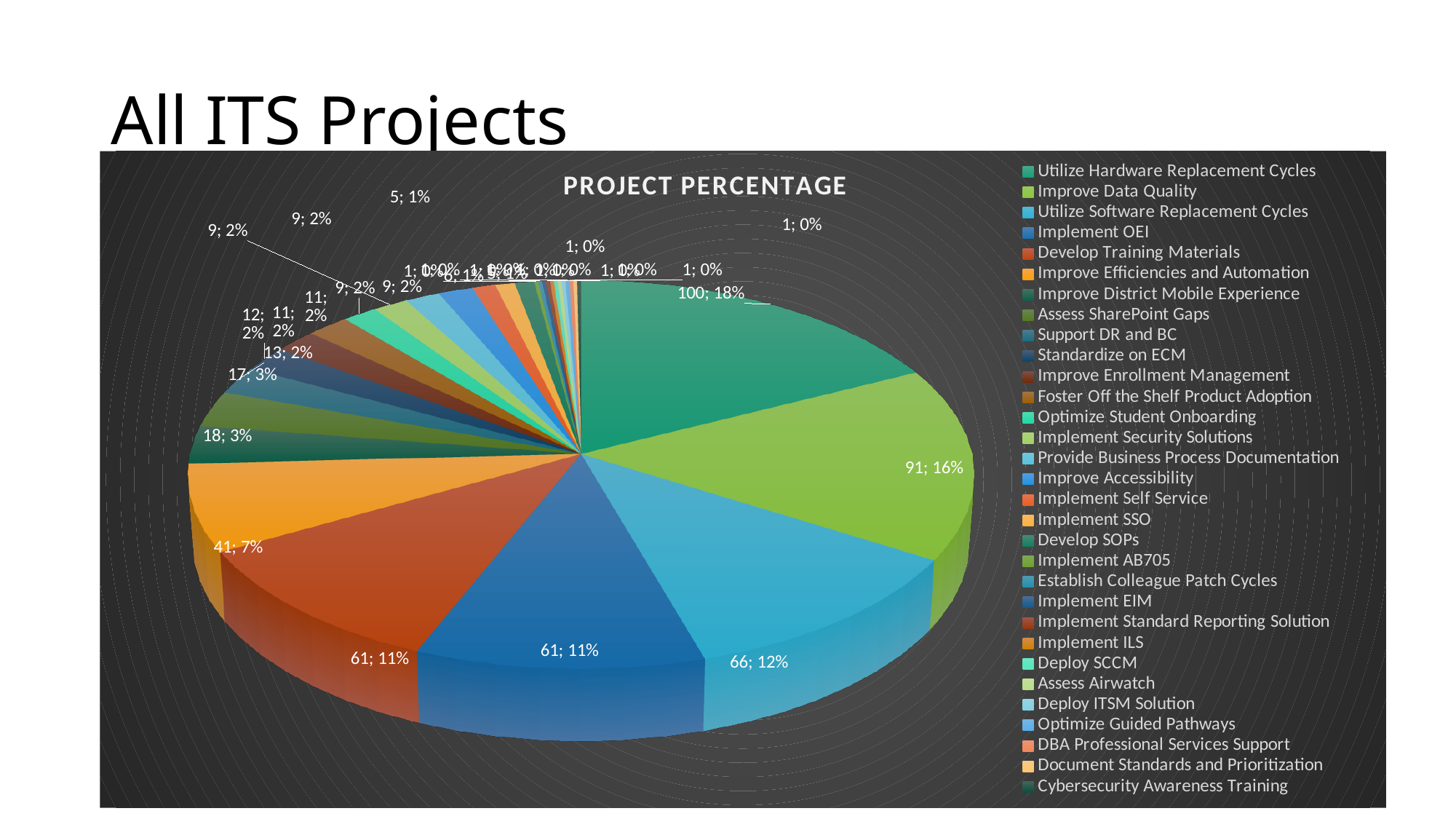
Which is larger, the slice for Utilize Software Replacement Cycles or the slice for Implement OEI? Utilize Software Replacement Cycles What value and percentage are labelled on the Utilize Hardware Replacement Cycles slice? 100; 18% What share of the pie does Improve Efficiencies and Automation represent? 7% What share of the pie does Improve Data Quality represent? 16% What value is labelled on the Implement OEI slice? 61 What kind of chart is shown on the slide? Pie chart What is the title of the chart? PROJECT PERCENTAGE What value is labelled on the Utilize Software Replacement Cycles slice? 66 How many categories does the legend list? 31 What is the difference between the values for Utilize Hardware Replacement Cycles and Improve Data Quality? 9 What is the difference between the values for Utilize Software Replacement Cycles and Improve Efficiencies and Automation? 25 Which category has the largest slice of the pie? Utilize Hardware Replacement Cycles